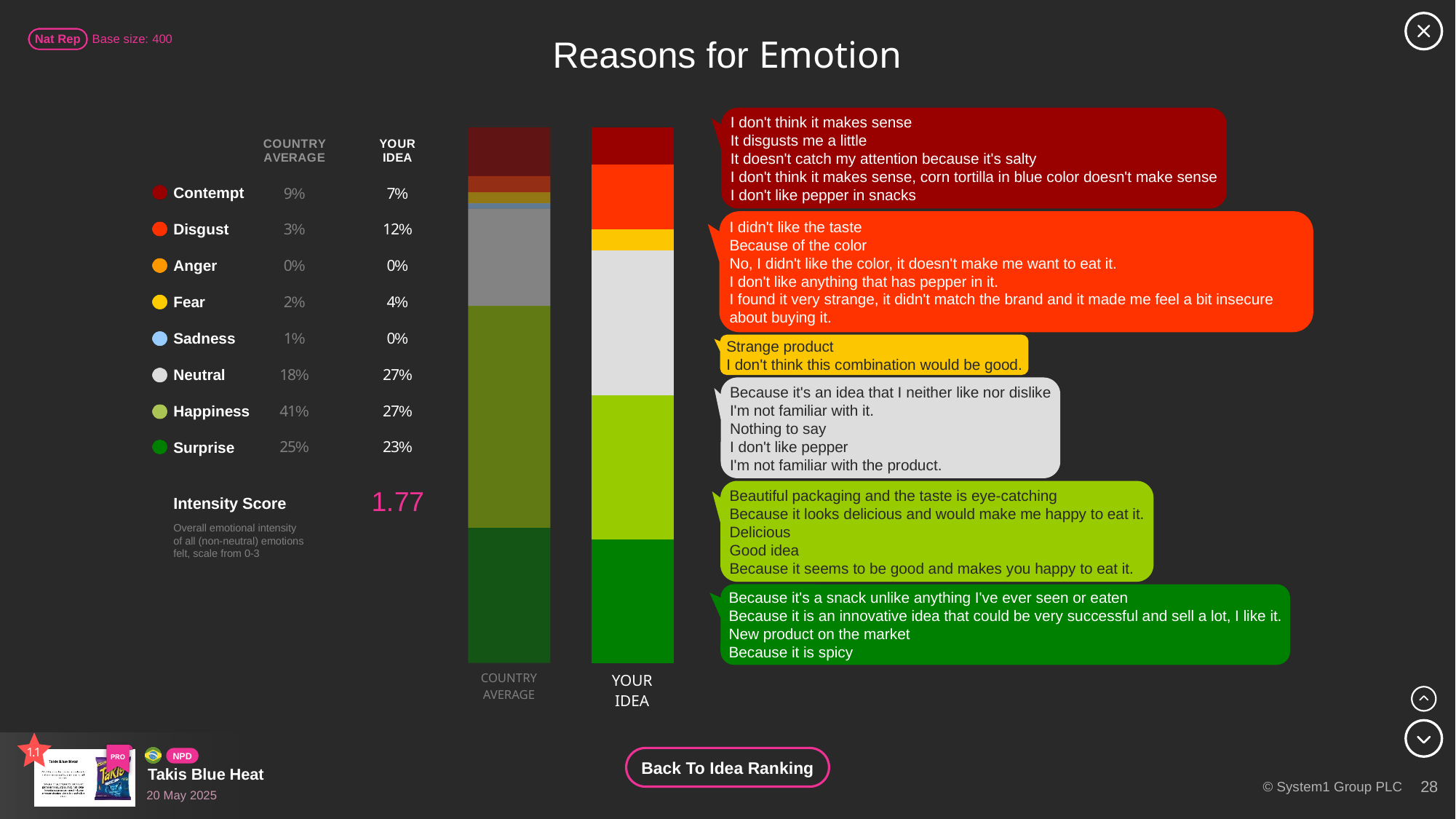
What is the Your Idea value for Disgust? 12% What is the Country Average value for Happiness? 41% What is the base size shown on the slide? 400 What kind of chart is shown on the slide? Stacked bar chart Which emotion has the highest Country Average value? Happiness How many emotion categories are listed in the chart? 8 What is the Intensity Score shown on the slide? 1.77 For Disgust, which is larger: the Your Idea value or the Country Average value? Your Idea What is the difference between the Your Idea and Country Average values for Neutral? 9 percentage points What is the total of the Your Idea stacked bar? 100% How many stacked bars are shown in the chart? 2 Which emotion has the lowest Country Average value? Anger